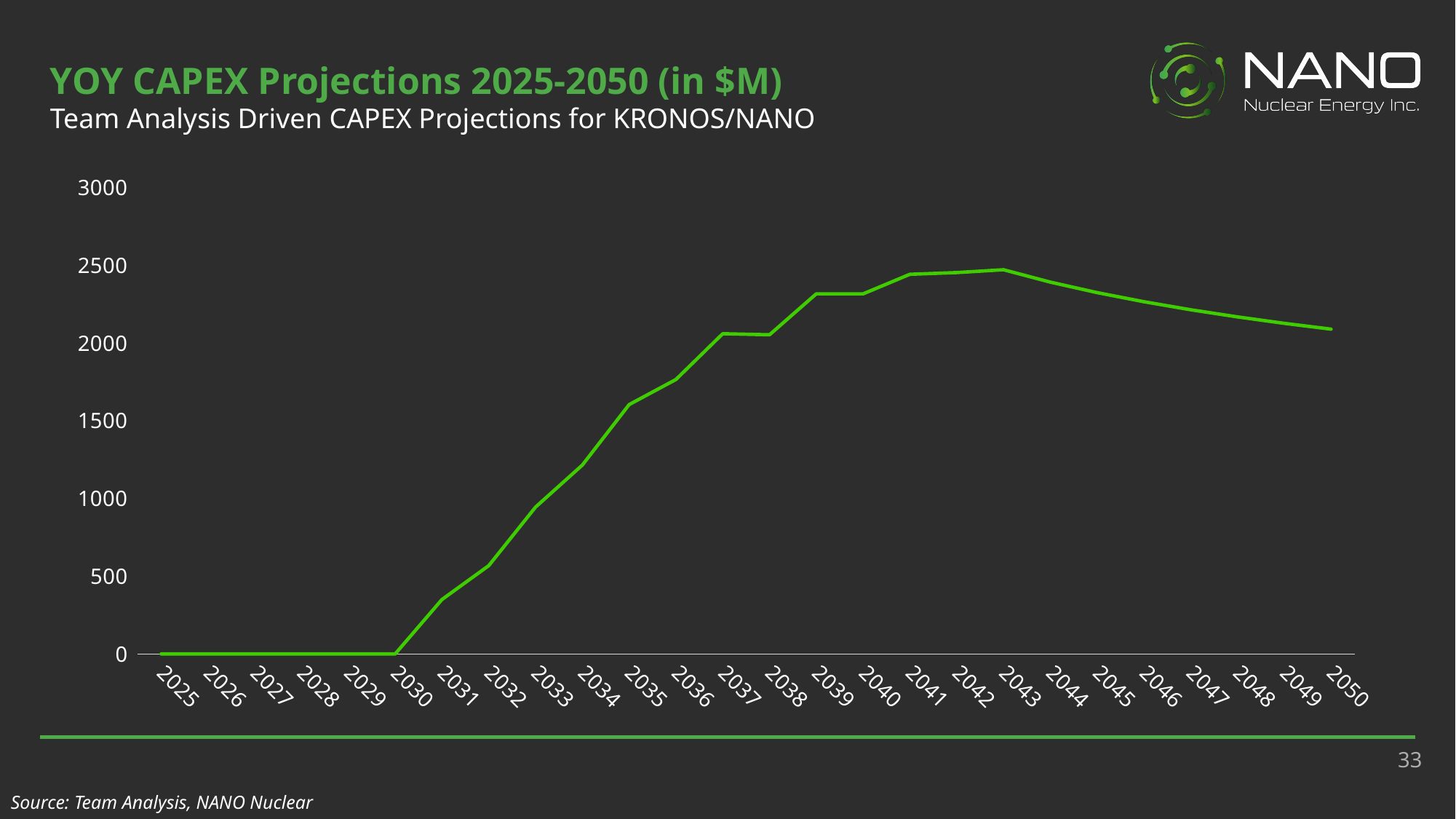
What is the title of the chart? YOY CAPEX Projections 2025-2050 (in $M) Which year has the larger CAPEX value, 2043 or 2050? 2043 Is the value for 2045 greater or less than 2000? greater Is the value for 2031 greater or less than 500? less Which year has the highest CAPEX projection? 2043 What kind of chart is shown on the slide? line chart What is the CAPEX value for 2030? 0 Is the value for 2033 greater or less than 1000? less How many years are plotted along the x axis? 26 What is the CAPEX value for 2025? 0 Do the values rise or fall from 2043 to 2050? fall